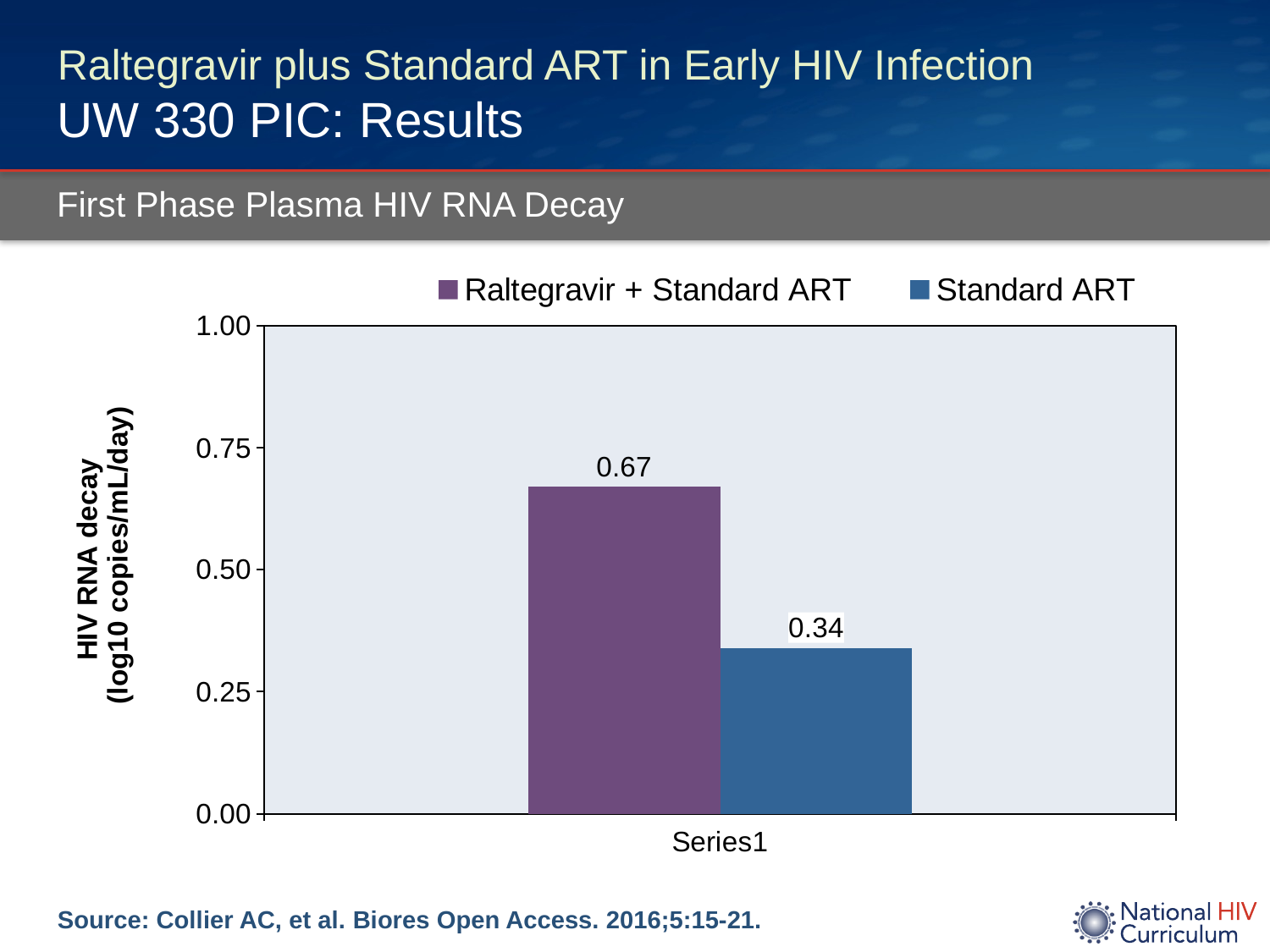
What is the maximum value shown on the y-axis? 1.00 What is the HIV RNA decay value for Raltegravir + Standard ART? 0.67 What is the HIV RNA decay value for Standard ART? 0.34 What is the y-axis label of the chart? HIV RNA decay (log10 copies/mL/day) Which series has the lower HIV RNA decay value? Standard ART Is the value for Standard ART greater or less than 0.50? less What is the difference between the Raltegravir + Standard ART value and the Standard ART value? 0.33 How many series does the legend list? 2 What kind of chart is shown on the slide? bar chart Is the value for Raltegravir + Standard ART larger or smaller than the value for Standard ART? larger Is the value for Raltegravir + Standard ART greater or less than 0.50? greater Which series has the higher HIV RNA decay value? Raltegravir + Standard ART